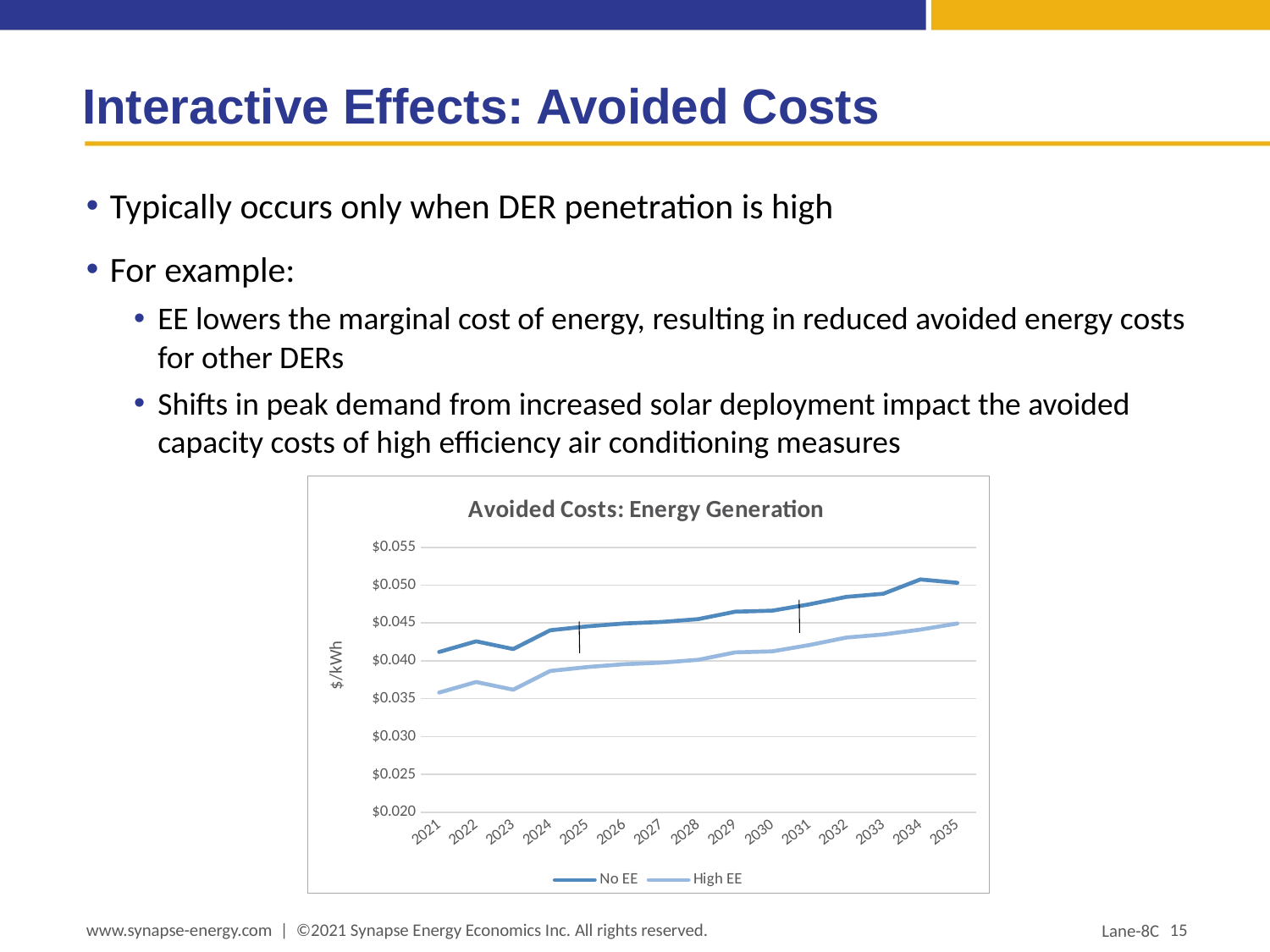
Is the High EE value for 2021 greater or less than $0.040? less What are the names of the two series in the legend? No EE and High EE What is the title of the chart? Avoided Costs: Energy Generation Is the No EE value for 2035 greater or less than $0.045? greater Is the High EE value for 2035 greater or less than $0.040? greater How many series does the chart's legend list? 2 Do the High EE values generally rise or fall from 2021 to 2035? rise What is the label on the y axis of the chart? $/kWh In 2030, which series has the larger value, No EE or High EE? No EE How many years are shown along the x axis of the chart? 15 Do the No EE values generally rise or fall from 2021 to 2035? rise What kind of chart is shown on the slide? line chart